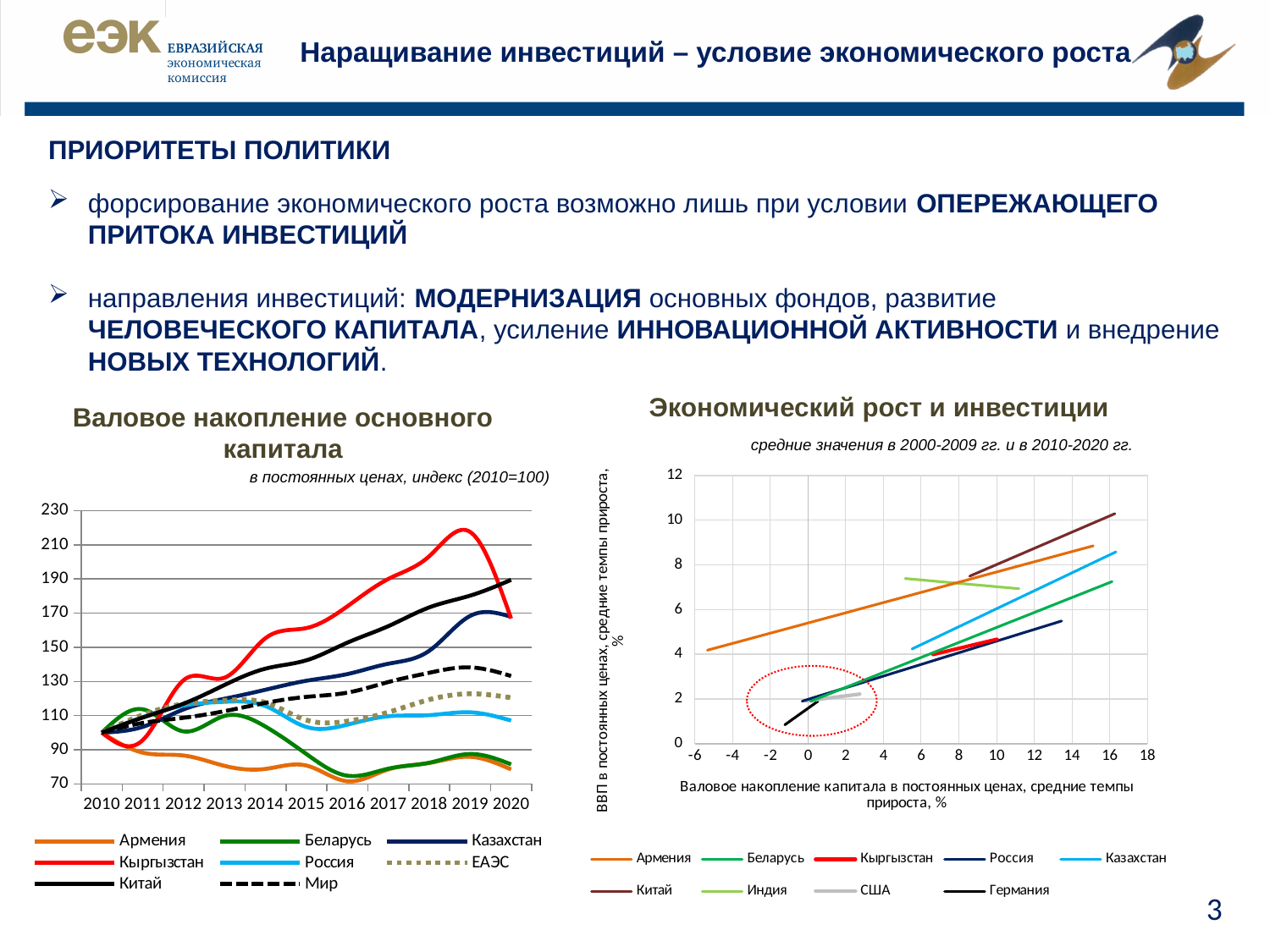
What is the subtitle printed under the title of the right chart "Экономический рост и инвестиции"? средние значения в 2000-2009 гг. и в 2010-2020 гг. In the right chart "Экономический рост и инвестиции", which series reaches the highest value on the vertical axis? Китай In the left chart "Валовое накопление основного капитала", which series reaches the highest value in 2019? Кыргызстан In the left chart "Валовое накопление основного капитала", does the line for Китай rise or fall from 2010 to 2020? rise How many series does the legend of the left chart "Валовое накопление основного капитала" list? 8 What kind of chart is the left chart titled "Валовое накопление основного капитала"? line chart In the left chart "Валовое накопление основного капитала", is the value for Армения in 2016 greater or less than 90? less In the left chart "Валовое накопление основного капитала", is the value for Кыргызстан in 2019 greater or less than 210? greater How many series does the legend of the right chart "Экономический рост и инвестиции" list? 9 In the left chart "Валовое накопление основного капитала", is the value for Китай in 2020 greater or less than 170? greater In the left chart "Валовое накопление основного капитала", which is larger in 2020: the value for Китай or the value for Россия? Китай How many years are shown on the x axis of the left chart "Валовое накопление основного капитала"? 11